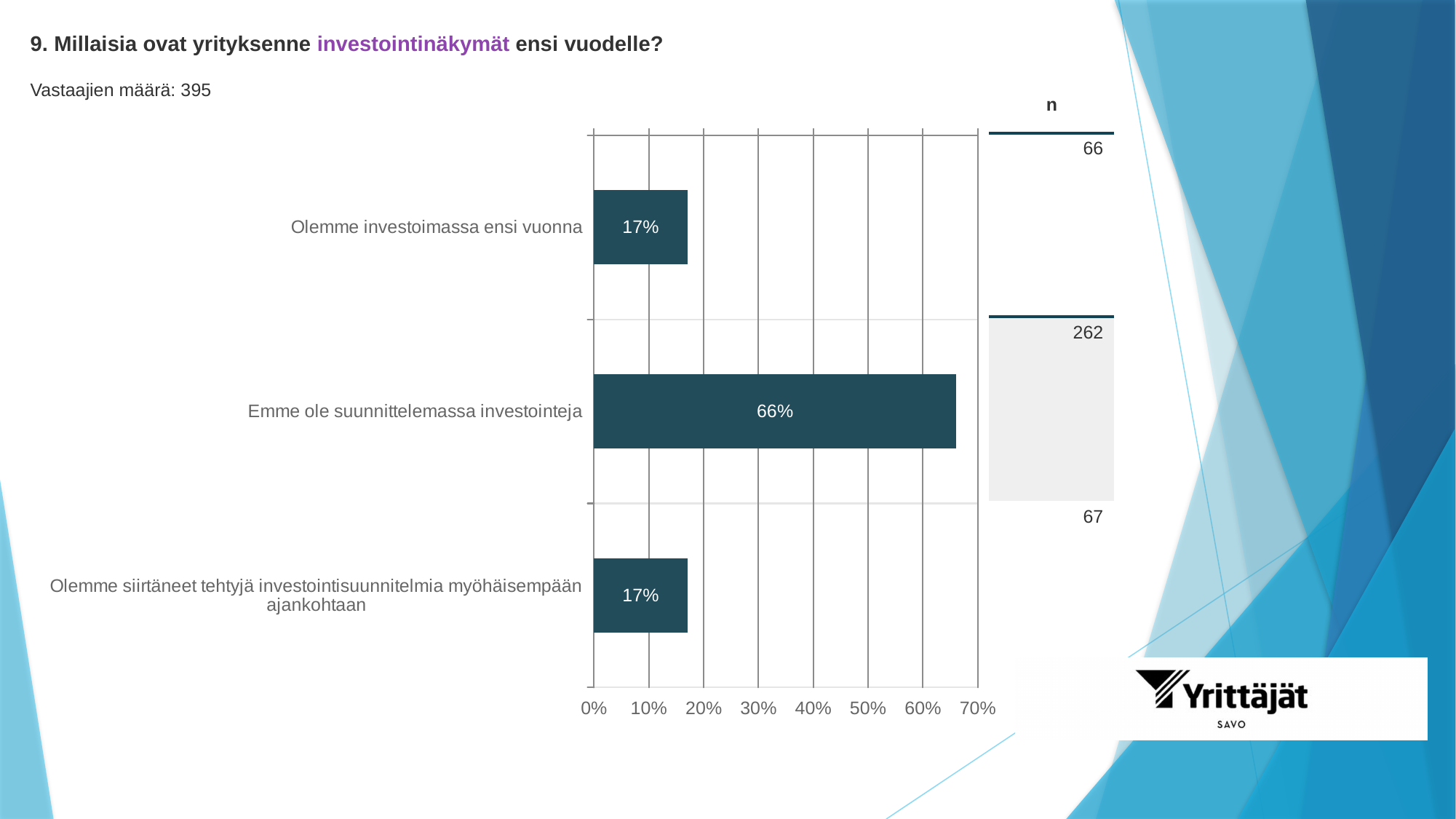
Is the value for "Olemme investoimassa ensi vuonna" greater or less than 20%? less How many categories are shown in the chart? 3 Which is larger: the value for "Emme ole suunnittelemassa investointeja" or the value for "Olemme siirtäneet tehtyjä investointisuunnitelmia myöhäisempään ajankohtaan"? Emme ole suunnittelemassa investointeja Which category has the highest percentage? Emme ole suunnittelemassa investointeja Is the value for "Emme ole suunnittelemassa investointeja" greater or less than 60%? greater What percentage of respondents answered "Olemme siirtäneet tehtyjä investointisuunnitelmia myöhäisempään ajankohtaan"? 17% What is the difference in percentage points between "Emme ole suunnittelemassa investointeja" and "Olemme investoimassa ensi vuonna"? 49 percentage points What kind of chart is shown on the slide? Bar chart What is the total number of respondents (Vastaajien määrä) stated on the slide? 395 What percentage of respondents answered "Olemme investoimassa ensi vuonna"? 17% What is the n value (number of respondents) for "Emme ole suunnittelemassa investointeja"? 262 What percentage of respondents answered "Emme ole suunnittelemassa investointeja"? 66%